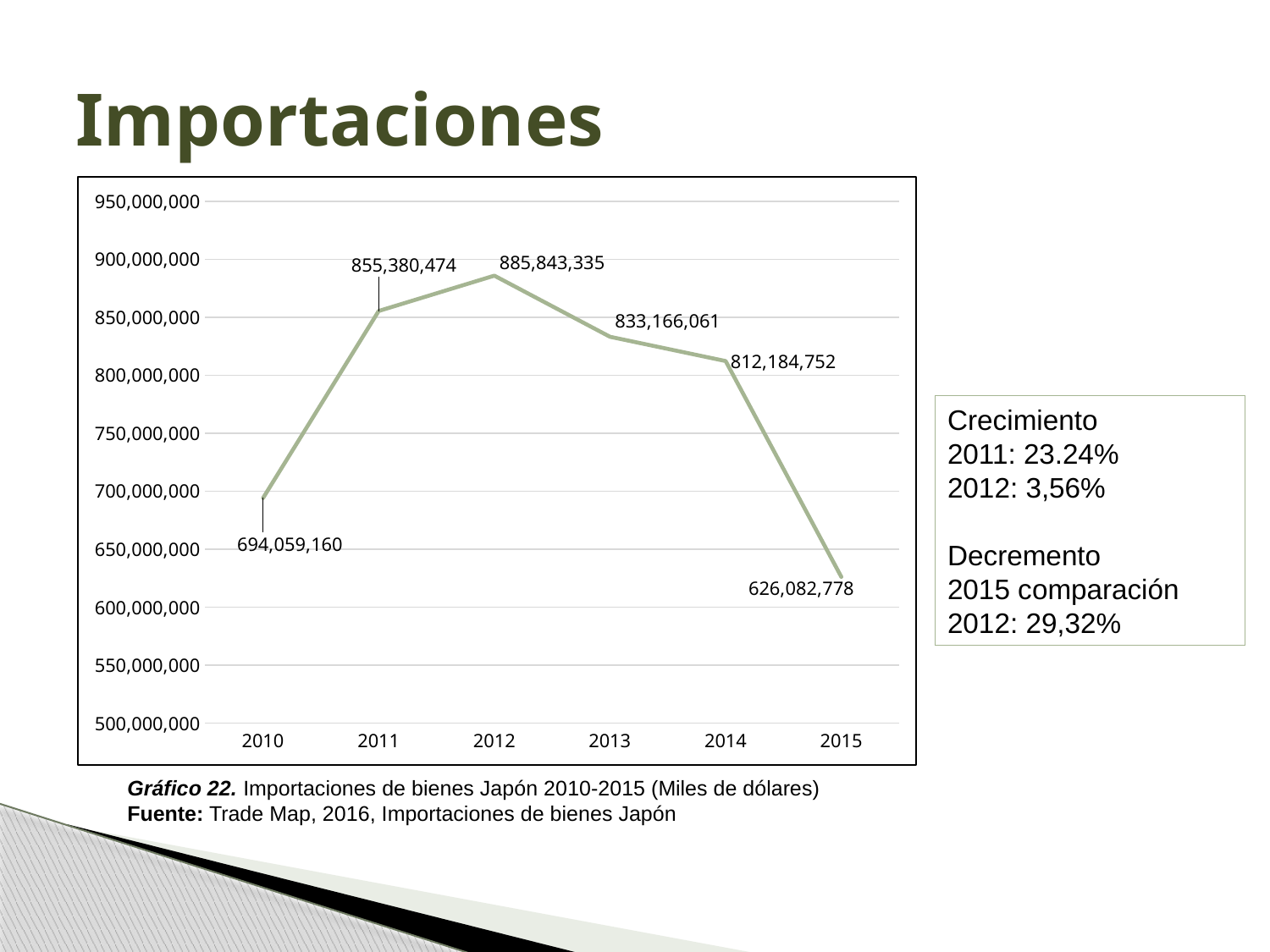
Which year has the lowest value? 2015 Which is larger, the value for 2013 or the value for 2014? 2013 What is the difference between the values for 2014 and 2015? 186,101,974 How many years are plotted on the chart? 6 What is the value for 2012? 885,843,335 What is the value for 2015? 626,082,778 Is the value for 2011 greater or less than 850,000,000? greater What is the difference between the values for 2012 and 2011? 30,462,861 What is the value for 2014? 812,184,752 What is the value for 2010? 694,059,160 What kind of chart is shown on the slide? line chart Which year has the highest value? 2012